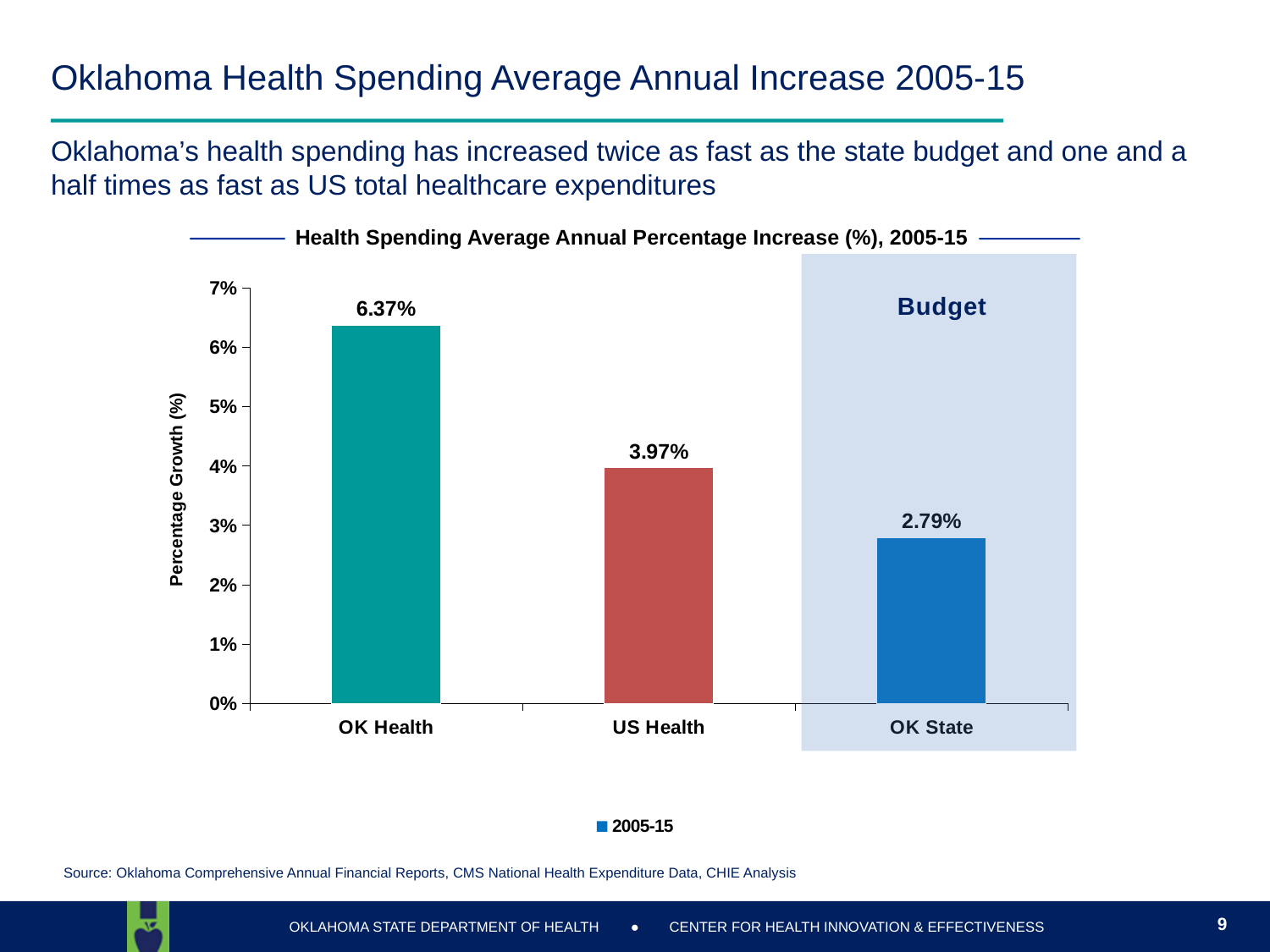
Which category has the lowest average annual percentage increase? OK State What is the difference between the values for OK Health and US Health? 2.40% What is the value for OK Health? 6.37% Is the value for OK Health greater or less than 6%? greater What is the value for OK State? 2.79% What is the value for US Health? 3.97% Which category has the highest average annual percentage increase? OK Health Which is larger, the value for US Health or the value for OK State? US Health What kind of chart is shown on the slide? bar chart What is the difference between the values for US Health and OK State? 1.18% How many categories are shown on the x axis? 3 What is the title of the chart? Health Spending Average Annual Percentage Increase (%), 2005-15